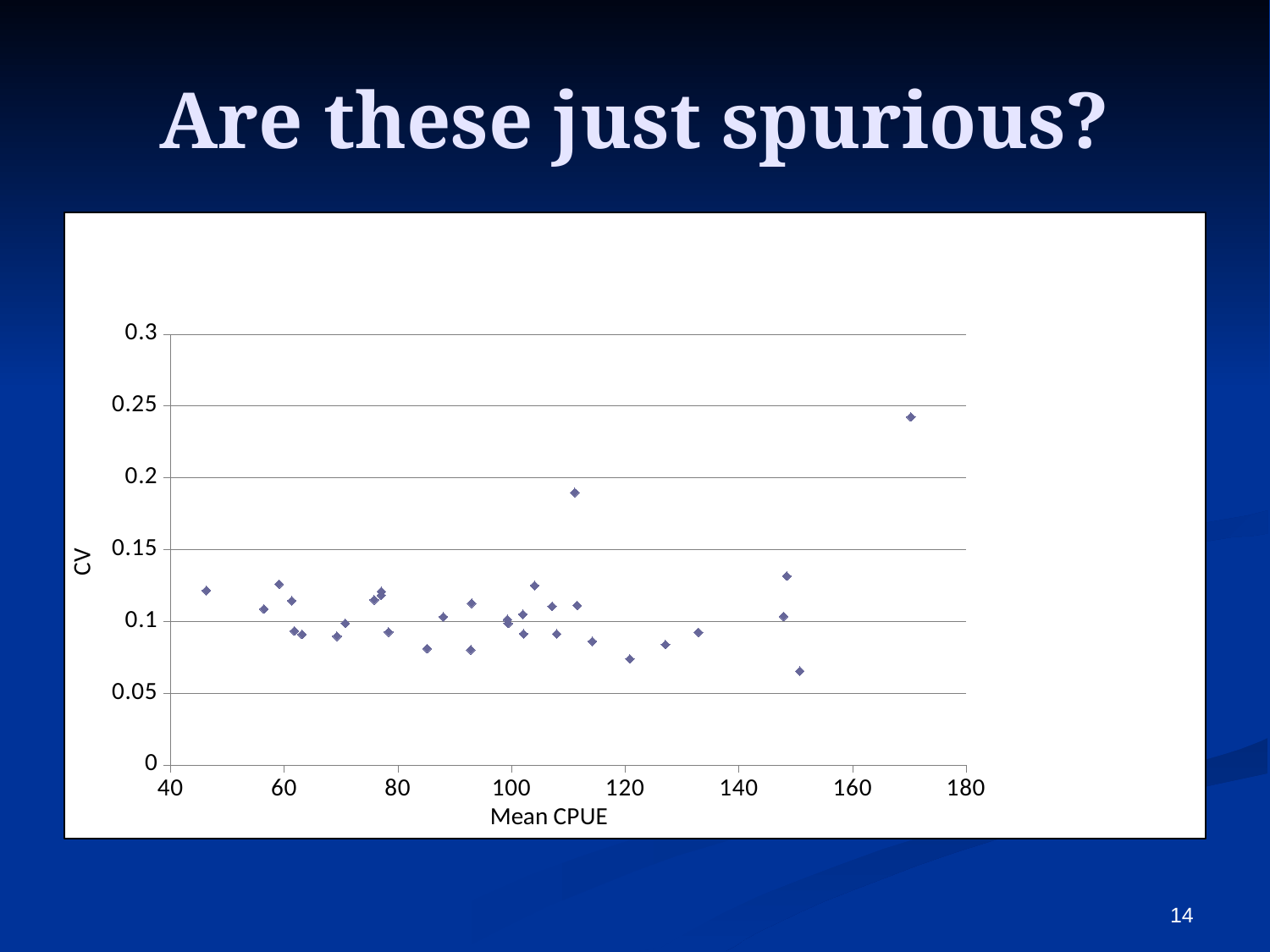
Is the lowest CV value plotted greater or less than 0.1? less How many points have a CV above 0.15? 2 Is the CV of the leftmost point (near Mean CPUE 46) greater or less than 0.1? greater What is the title of the y axis of the chart? CV Is the CV of the point near Mean CPUE 121 greater or less than 0.1? less What kind of chart is shown on the slide? scatter plot What is the title of the x axis of the chart? Mean CPUE How many points have a Mean CPUE above 140? 4